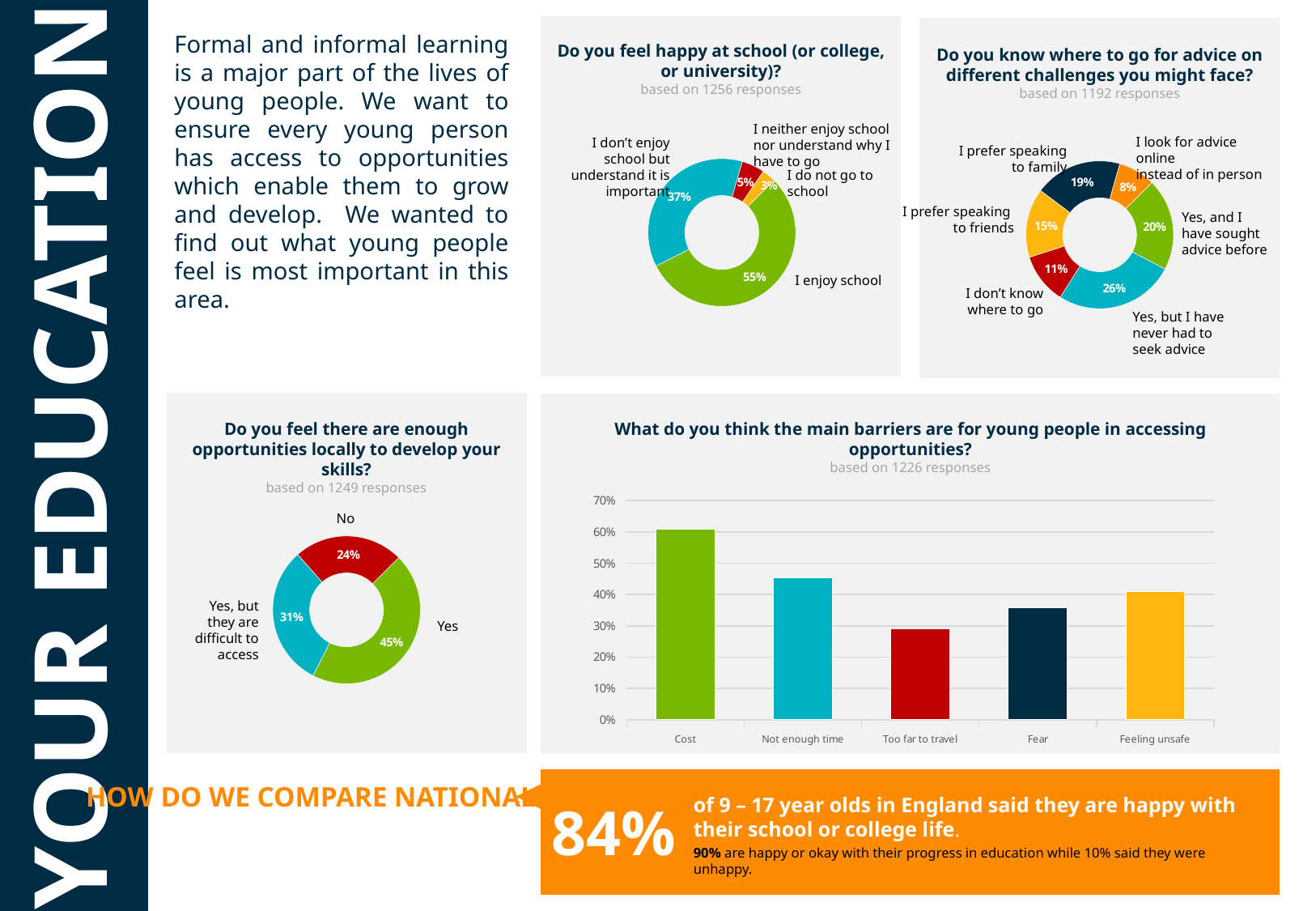
In the chart 'Do you feel happy at school (or college, or university)?', what is the difference between 'I enjoy school' and 'I don't enjoy school but understand it is important'? 18% What kind of chart is 'What do you think the main barriers are for young people in accessing opportunities?'? Bar chart In the chart 'Do you feel happy at school (or college, or university)?', what percentage said 'I do not go to school'? 3% In the chart 'Do you know where to go for advice on different challenges you might face?', what percentage said 'I don't know where to go'? 11% In the chart 'Do you know where to go for advice on different challenges you might face?', how many response categories are shown? 6 In the chart 'Do you feel there are enough opportunities locally to develop your skills?', which response has the smallest share? No In the chart 'Do you feel there are enough opportunities locally to develop your skills?', what percentage answered 'No'? 24% In the chart 'What do you think the main barriers are for young people in accessing opportunities?', which barrier has the highest value? Cost In the chart 'Do you know where to go for advice on different challenges you might face?', which response has the largest share? Yes, but I have never had to seek advice In the chart 'Do you know where to go for advice on different challenges you might face?', which is larger: 'I prefer speaking to family' or 'I prefer speaking to friends'? I prefer speaking to family In the chart 'Do you feel happy at school (or college, or university)?', what percentage of respondents said 'I enjoy school'? 55%